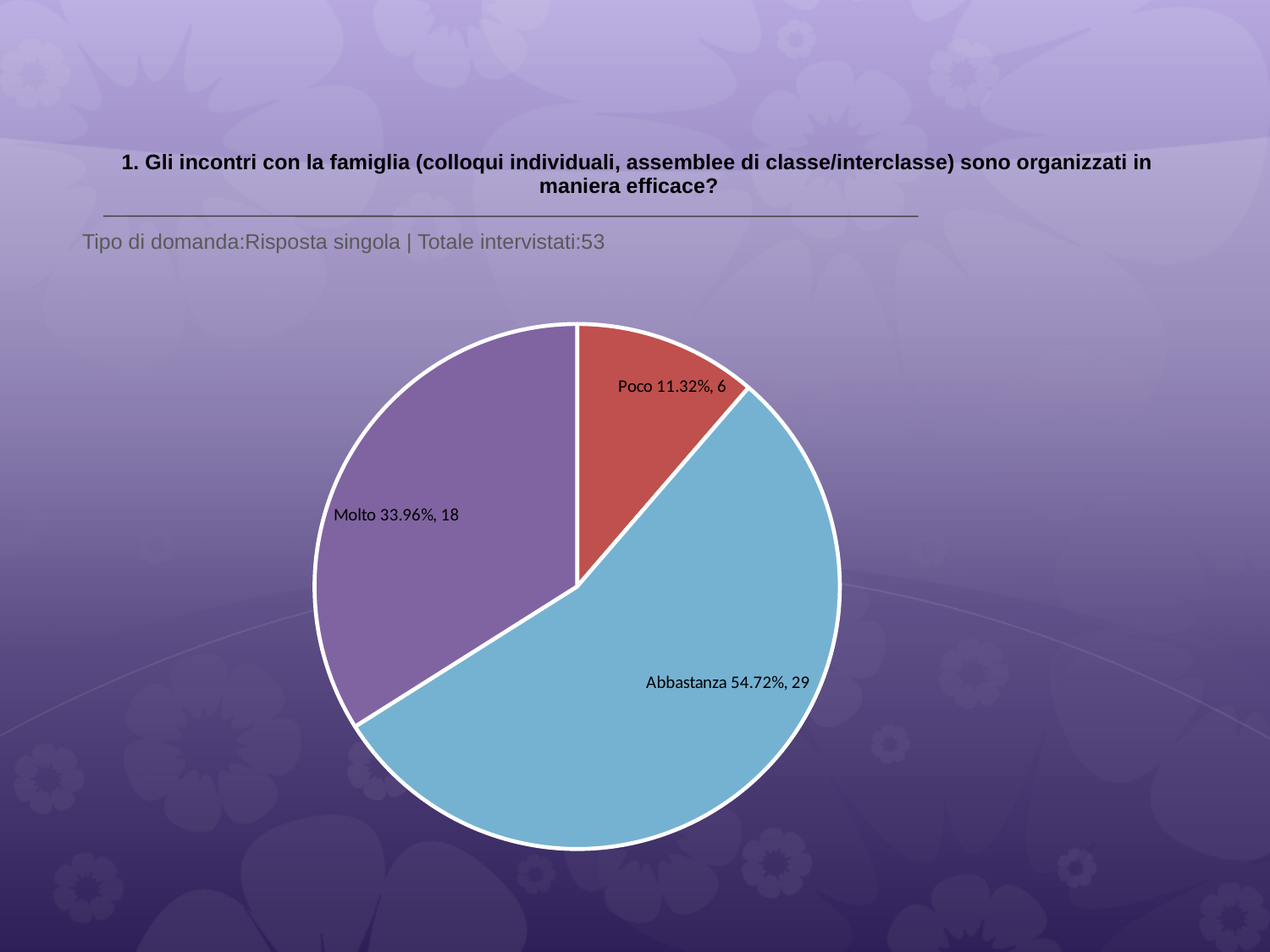
Which response category has the smallest slice? Poco What percentage share does the Poco slice have? 11.32% What is the difference in respondent count between Abbastanza and Molto? 11 How many respondents answered Poco? 6 How many slices does the pie chart have? 3 Which has more respondents, Molto or Poco? Molto How many respondents answered Abbastanza? 29 What percentage share does the Abbastanza slice have? 54.72% What percentage share does the Molto slice have? 33.96% How many respondents answered Molto? 18 What kind of chart is shown on the slide? pie chart Which response category has the largest slice? Abbastanza